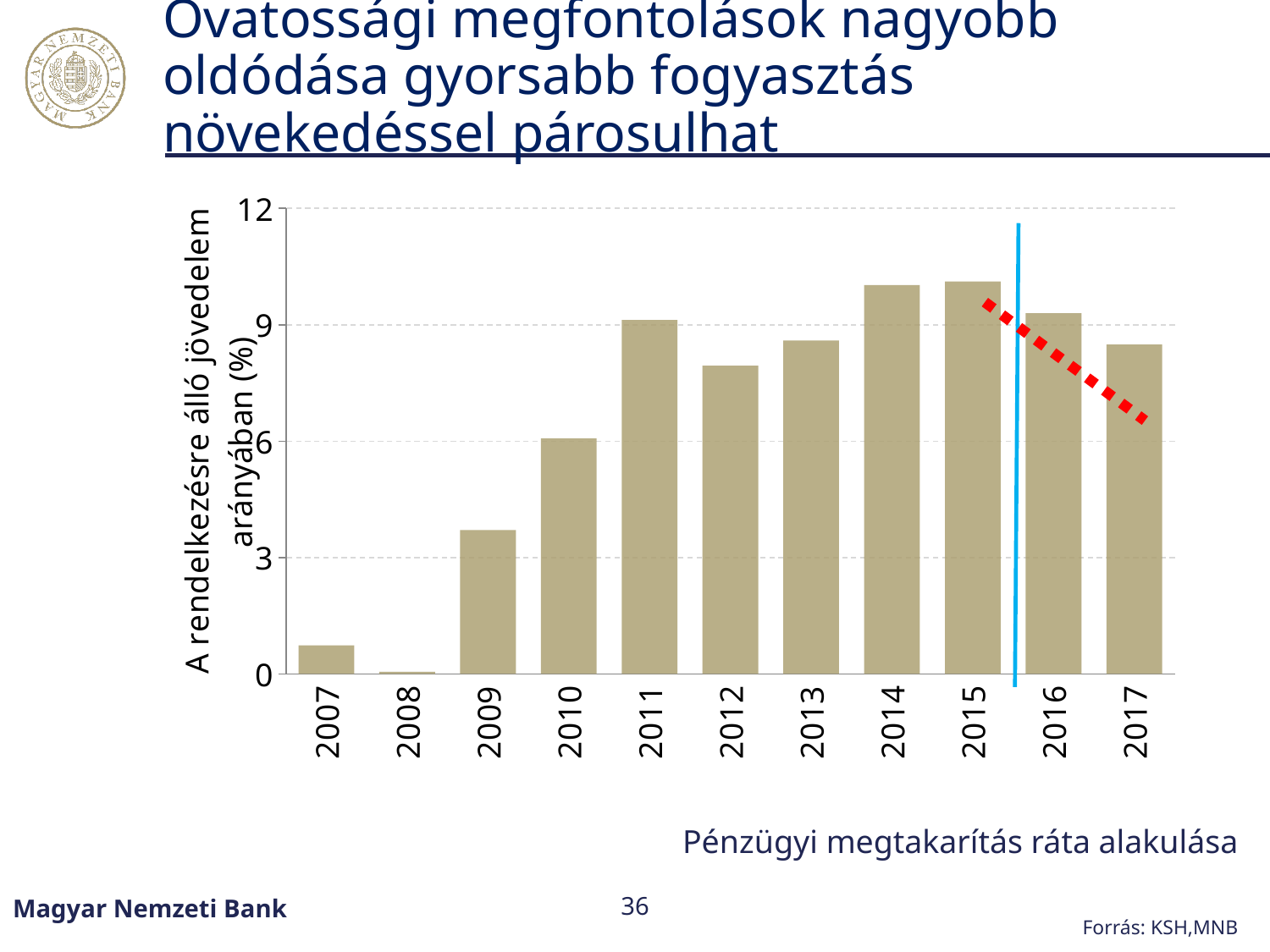
Is the value for 2012 greater or less than 9? less Is the value for 2014 greater or less than 9? greater Is the value for 2017 greater or less than 9? less What kind of chart is shown on the slide? bar chart Which year has the larger value, 2011 or 2012? 2011 How many years are shown on the x axis of the chart? 11 Do the values rise or fall from 2007 to 2011? rise Which year has the lowest value in the chart? 2008 Which year has the larger value, 2016 or 2017? 2016 What is the title of the chart shown below the plot area? Pénzügyi megtakarítás ráta alakulása